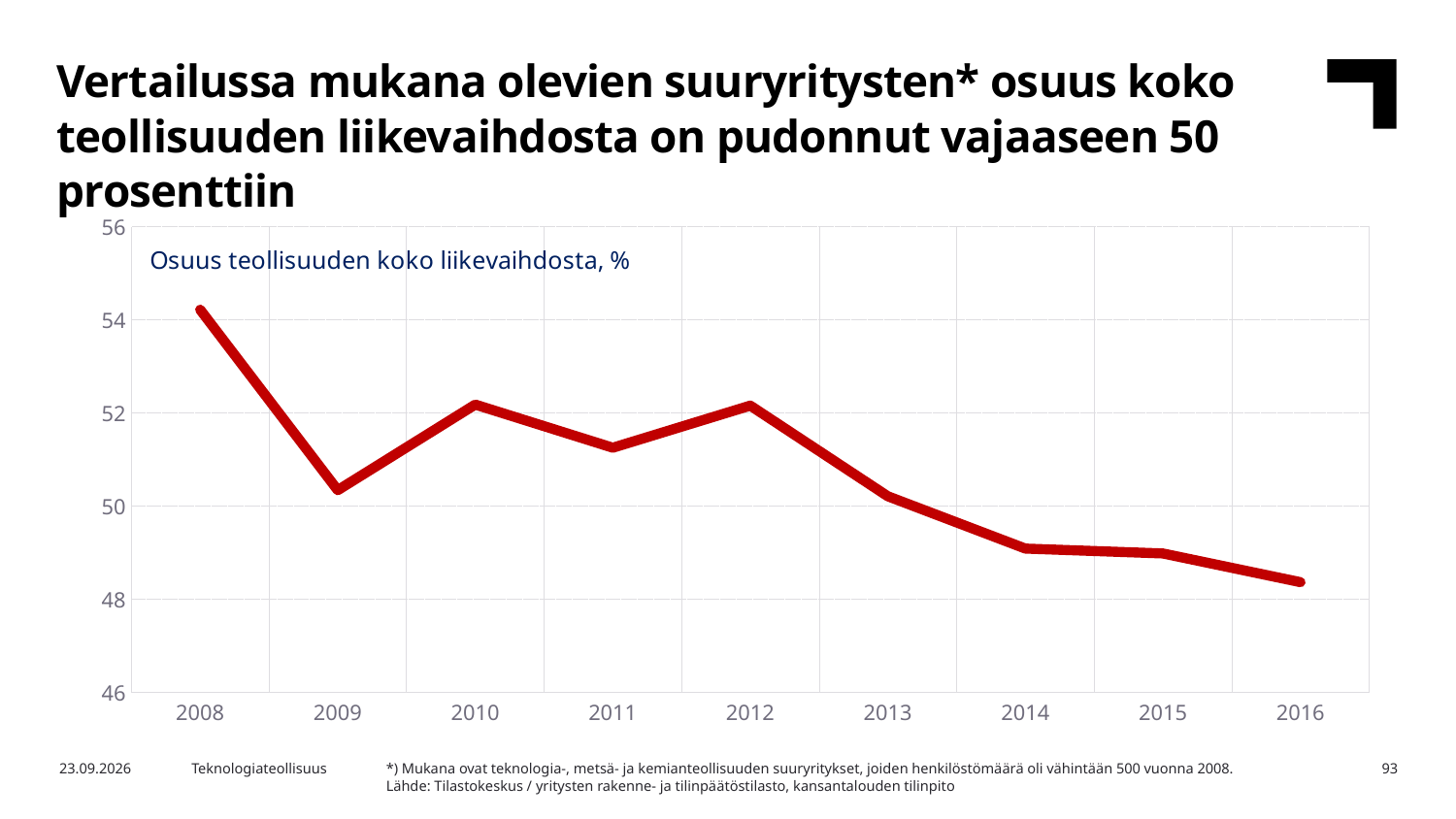
Is the value for 2014 greater or less than 50? less Which is larger, the value for 2008 or the value for 2016? 2008 Is the value for 2011 greater or less than 50? greater What is the label shown inside the chart area describing the plotted series? Osuus teollisuuden koko liikevaihdosta, % Which year has the lowest value in the chart? 2016 How many years are plotted on the x axis of the chart? 9 Which is larger, the value for 2009 or the value for 2011? 2011 Is the value for 2016 greater or less than 50? less Which year has the highest value in the chart? 2008 Overall, do the values rise or fall from 2008 to 2016? fall What kind of chart is shown on the slide? line chart